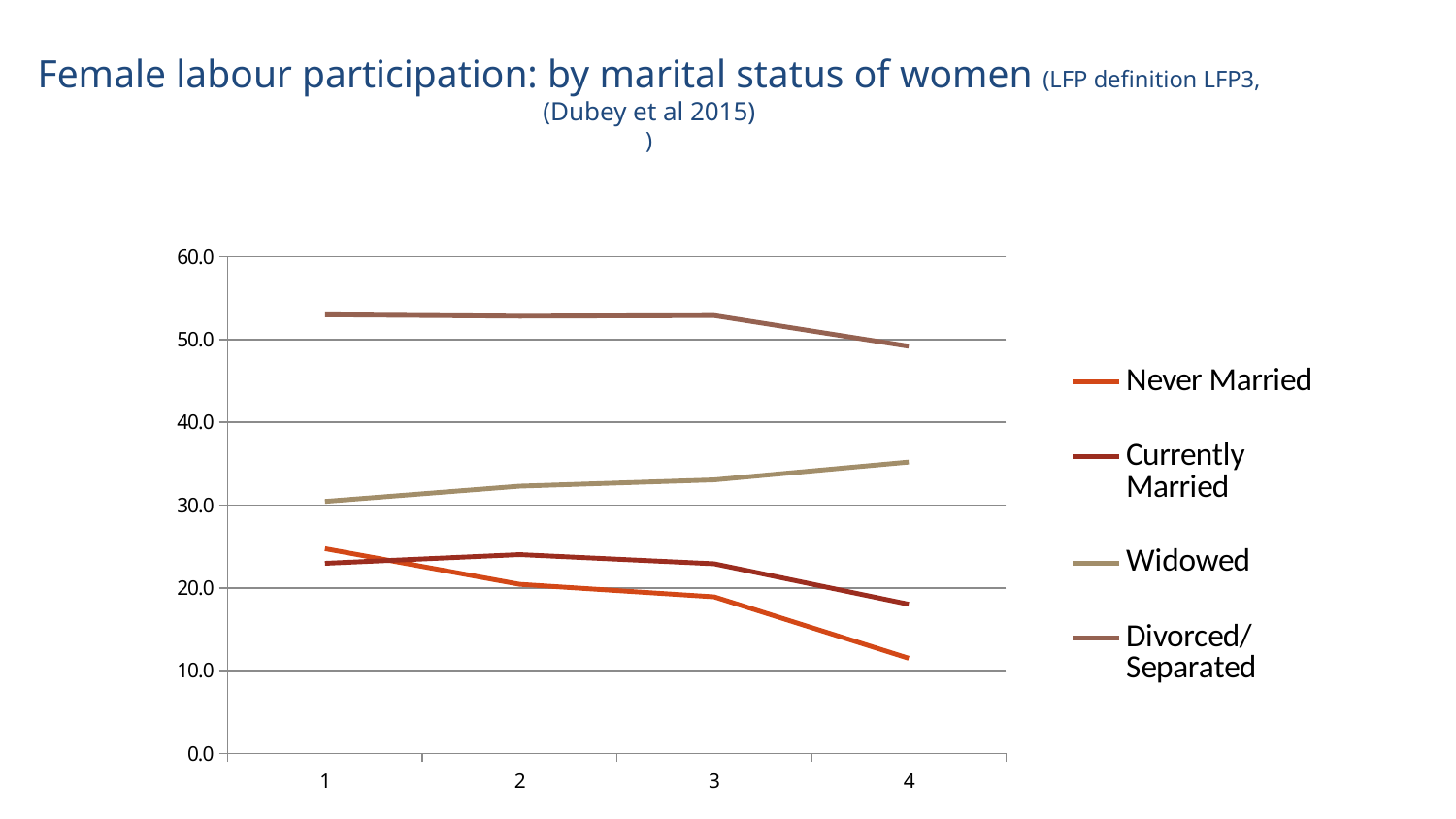
How many series does the legend list? 4 Does the Never Married line rise or fall from x = 1 to x = 4? fall Which series is drawn in the orange line? Never Married Which series has the highest value at x = 1? Divorced/Separated Is the value for Never Married at x = 4 greater or less than 20? less What kind of chart is shown on the slide? line chart How many points are there along the x axis? 4 Is the value for Divorced/Separated at x = 1 greater or less than 40? greater Which series has the lowest value at x = 4? Never Married Does the Widowed line rise or fall from x = 1 to x = 4? rise Is the value for Widowed at x = 4 greater or less than 30? greater At x = 4, which is larger: Currently Married or Never Married? Currently Married